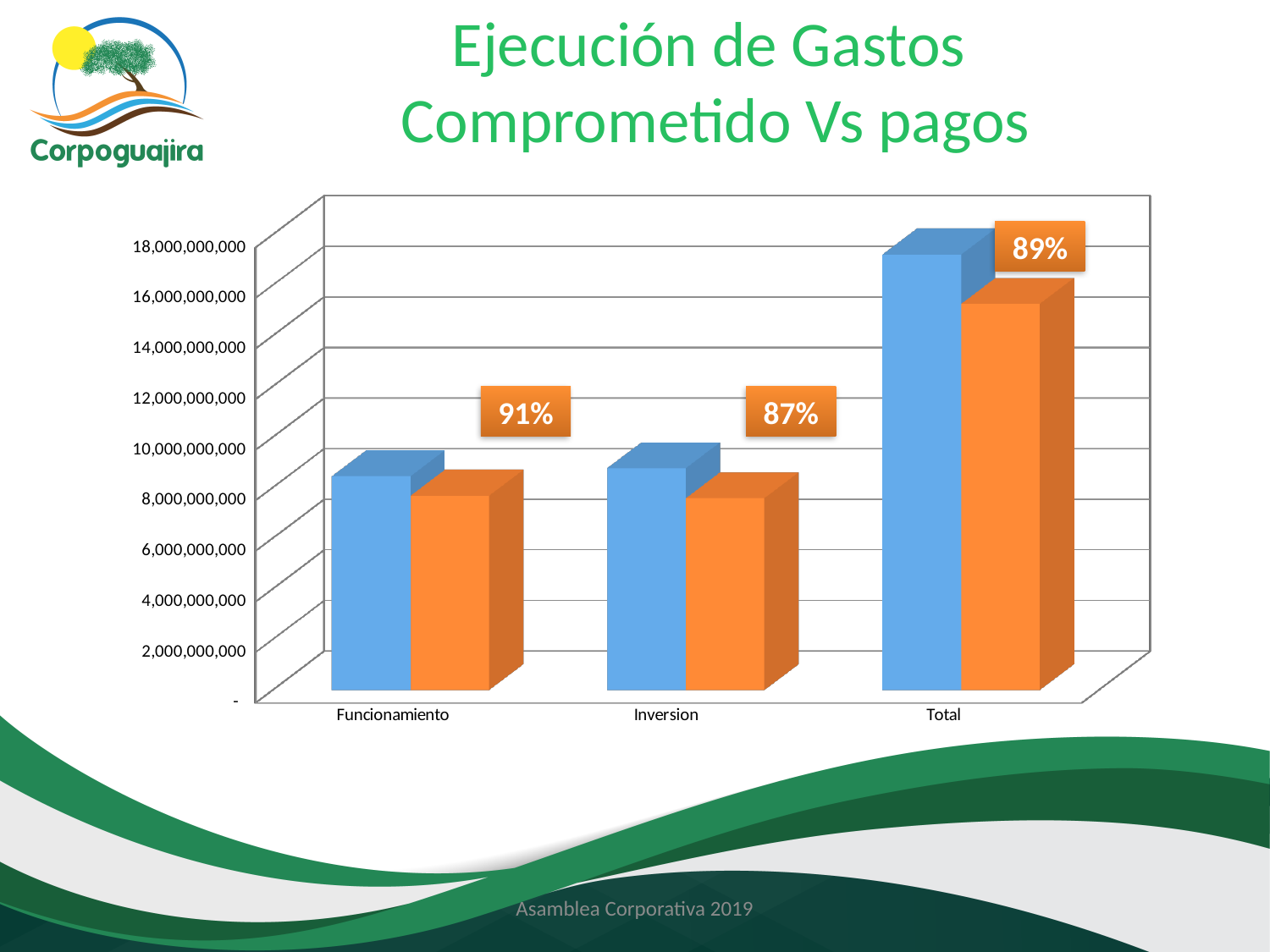
Which category has the tallest bars in the chart? Total What percentage label is shown above the Inversion bars? 87% What kind of chart is shown on the slide? bar chart What percentage label is shown above the Funcionamiento bars? 91% What is the difference between the percentage labels for Funcionamiento and Inversion? 4 percentage points What is the title of the chart on the slide? Ejecución de Gastos Comprometido Vs pagos How many categories are shown on the x axis of the chart? 3 What percentage label is shown above the Total bars? 89% Is the value of the blue bar for Funcionamiento greater or less than 10,000,000,000? less Which category has the highest percentage label? Funcionamiento Is the value of the blue bar for Total greater or less than 16,000,000,000? greater Which category has the lowest percentage label? Inversion